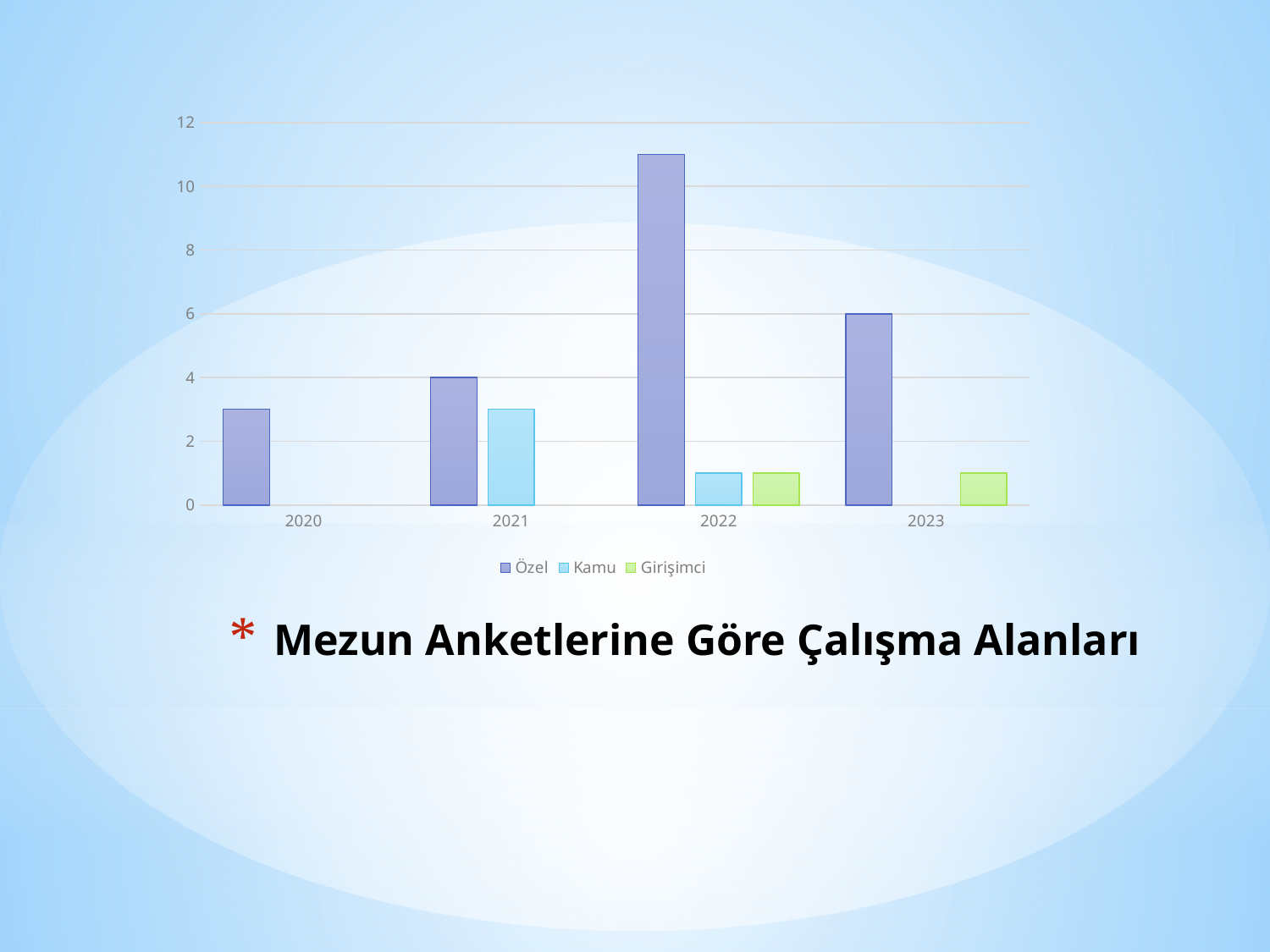
Is the value for Özel in 2022 greater or less than 10? greater What is the value for Özel in 2021? 4 What kind of chart is shown on the slide? bar chart In which year is the Özel value lowest? 2020 In 2021, which is larger, Özel or Kamu? Özel Is the value for Kamu in 2022 greater or less than 2? less What is the difference between the Özel values for 2023 and 2021? 2 How many series does the legend list? 3 What is the value for Özel in 2023? 6 How many years are shown on the x axis? 4 Which series is shown in green in the legend? Girişimci In which year is the Özel value highest? 2022